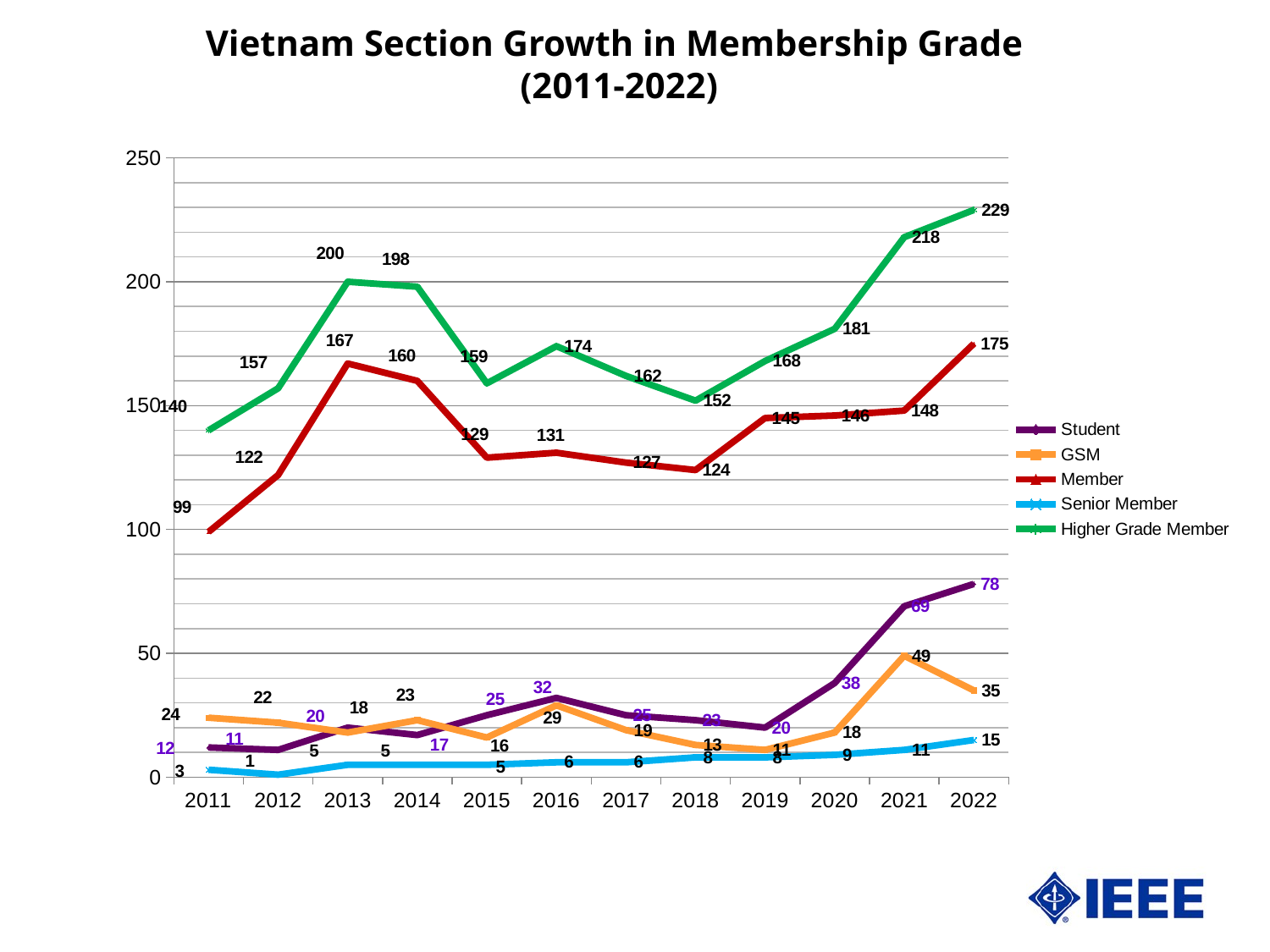
How many series does the legend list? 5 What is the value for Member in 2011? 99 What kind of chart is shown on the slide? Line chart In 2021, which is larger: the Student value or the GSM value? Student Does the Senior Member series generally rise or fall from 2011 to 2022? Rise What is the difference between the Higher Grade Member values in 2022 and 2011? 89 What is the value for Senior Member in 2022? 15 What is the value for Higher Grade Member in 2022? 229 How many years are shown on the x axis? 12 What is the value for GSM in 2021? 49 In which year does the Higher Grade Member series reach its highest value? 2022 In which year is the Member series at its lowest value? 2011